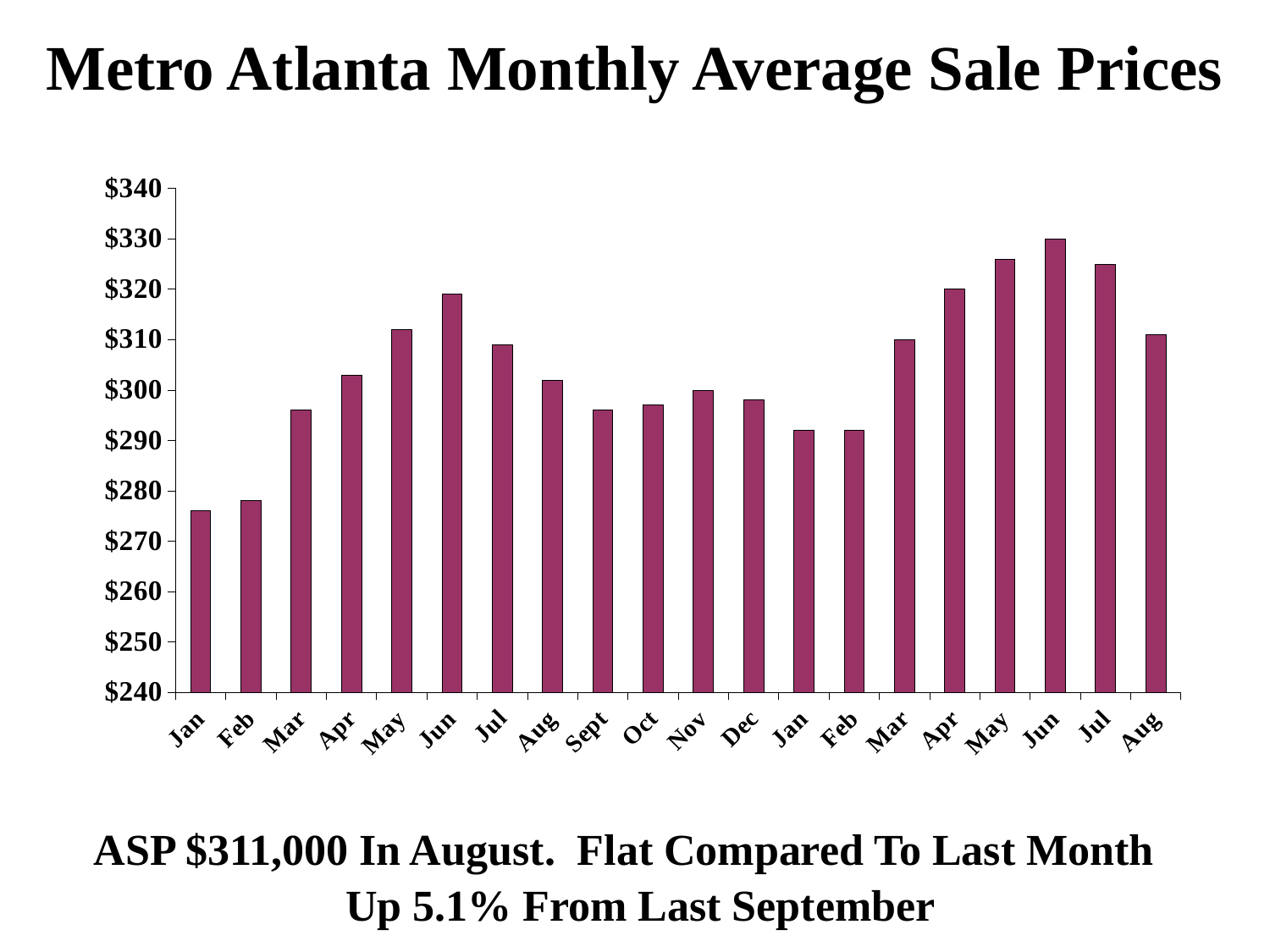
Is the value for the first Jan bar greater or less than $280? less What is the title of the chart? Metro Atlanta Monthly Average Sale Prices What type of chart is shown on the slide? bar chart What was the average sale price in the most recent August shown? $311,000 Which is larger, the first Jun bar or the second Jun bar? second Jun Is the value for the first Jun bar greater or less than $310? greater How many monthly bars are plotted in the chart? 20 Is the value for the second Jan bar greater or less than $300? less Which month has the highest average sale price in the chart? Jun (second year) Do the values rise or fall from the first Jan through the first Jun? rise